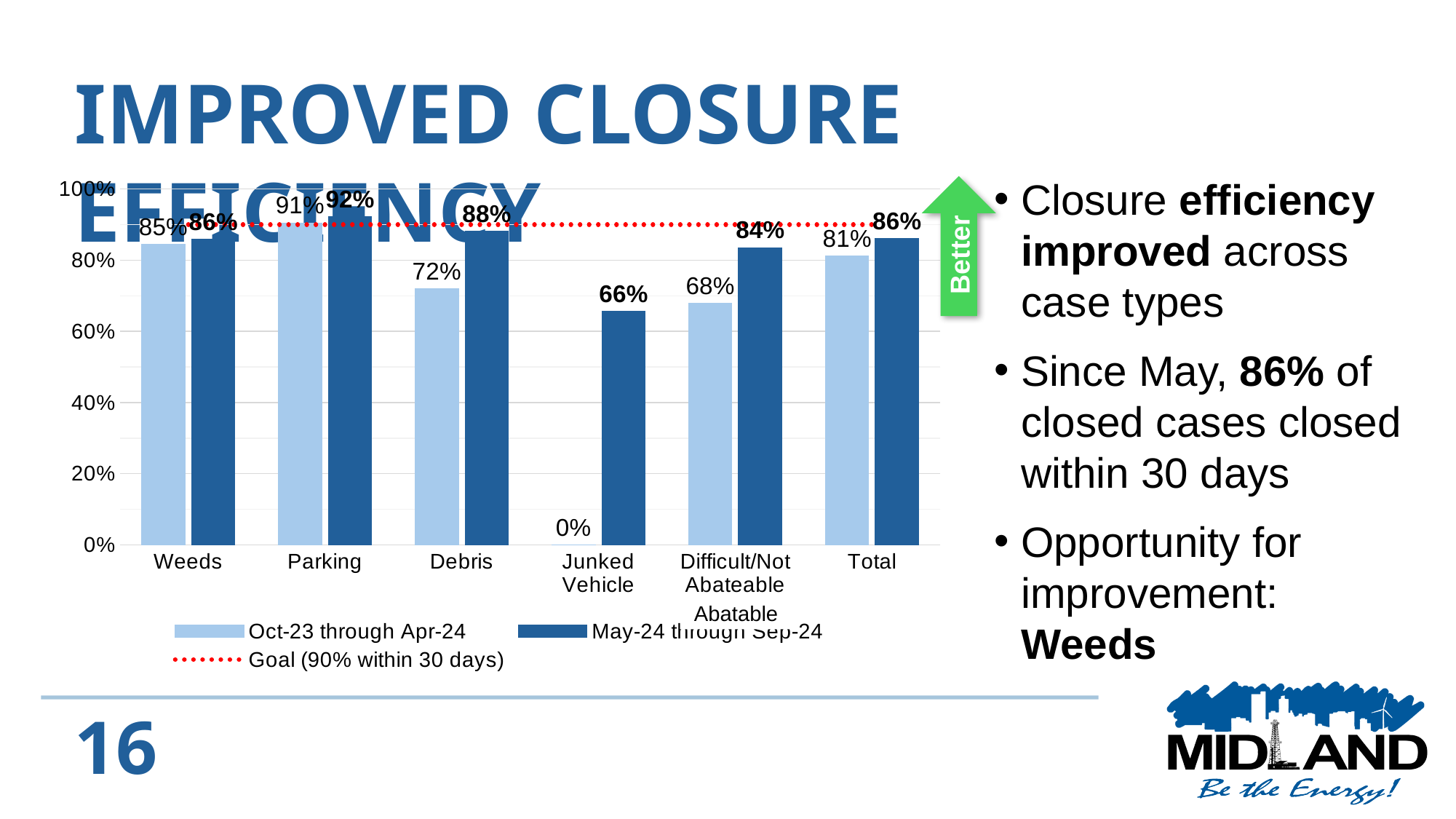
Which category has the highest May-24 through Sep-24 value? Parking How many categories are shown on the x axis? 6 What is the May-24 through Sep-24 value for Debris? 88% Is the May-24 through Sep-24 value for Junked Vehicle greater or less than 80%? less What is the Oct-23 through Apr-24 value for Difficult/Not Abateable? 68% Which is larger for Total: the Oct-23 through Apr-24 value or the May-24 through Sep-24 value? May-24 through Sep-24 What goal does the dotted red line in the legend represent? Goal (90% within 30 days) How many entries does the legend list? 3 What is the Oct-23 through Apr-24 value for Junked Vehicle? 0% What kind of chart is shown on the slide? bar chart What is the difference between the May-24 through Sep-24 and Oct-23 through Apr-24 values for Debris? 16% Which category has the lowest Oct-23 through Apr-24 value? Junked Vehicle